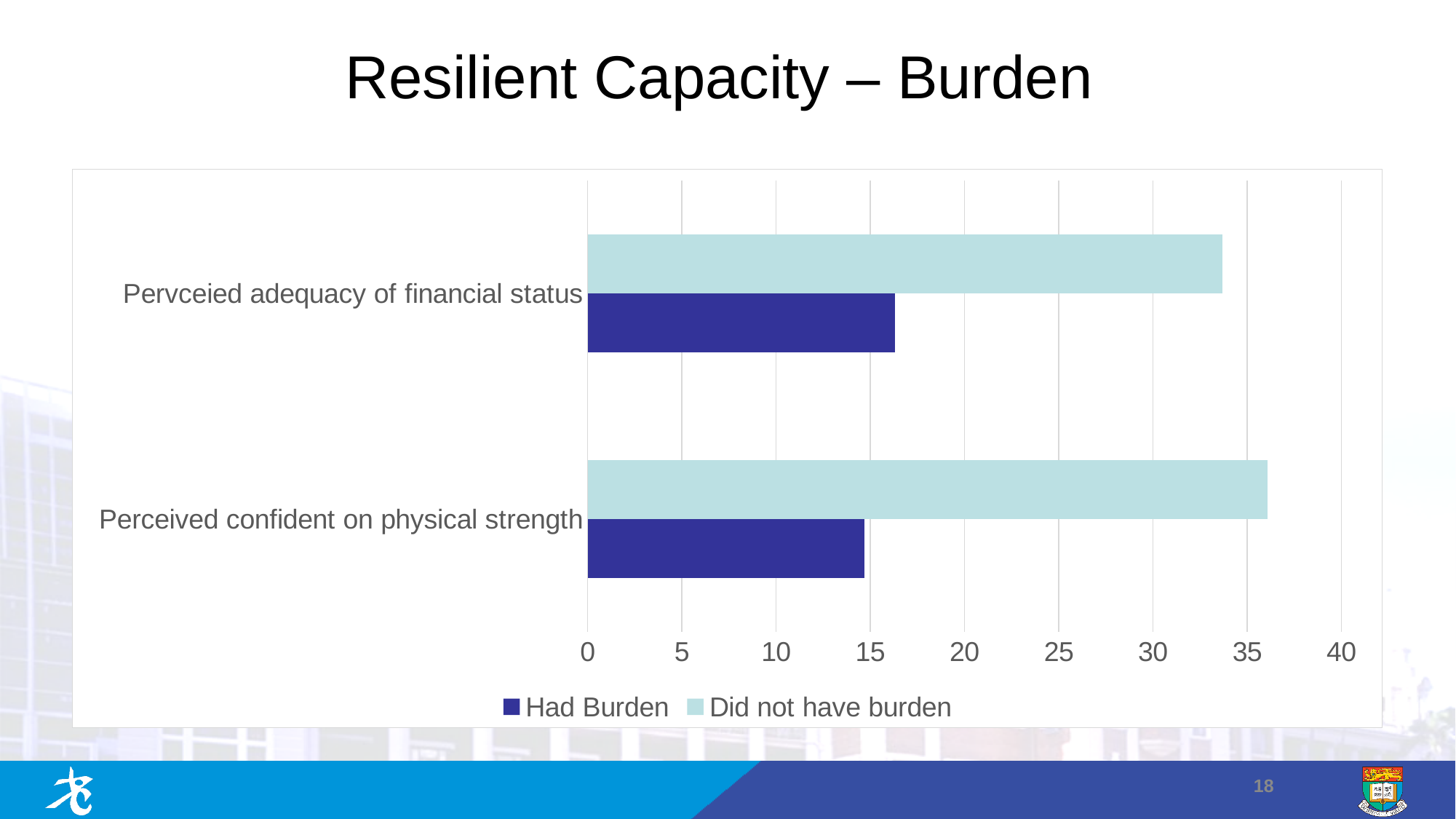
Is the Did not have burden value for Pervceied adequacy of financial status greater or less than 30? greater How many series does the legend list? 2 Is the Had Burden value for Pervceied adequacy of financial status greater or less than 15? greater Is the Had Burden value for Perceived confident on physical strength greater or less than 20? less Which series does the legend list first? Had Burden Which category has the highest value for Did not have burden? Perceived confident on physical strength What kind of chart is shown on the slide? bar chart What is the title of the slide containing the chart? Resilient Capacity – Burden How many categories are shown on the chart? 2 For Perceived confident on physical strength, which is larger: Had Burden or Did not have burden? Did not have burden For Pervceied adequacy of financial status, which is larger: Had Burden or Did not have burden? Did not have burden Which category has the lowest value for Had Burden? Perceived confident on physical strength